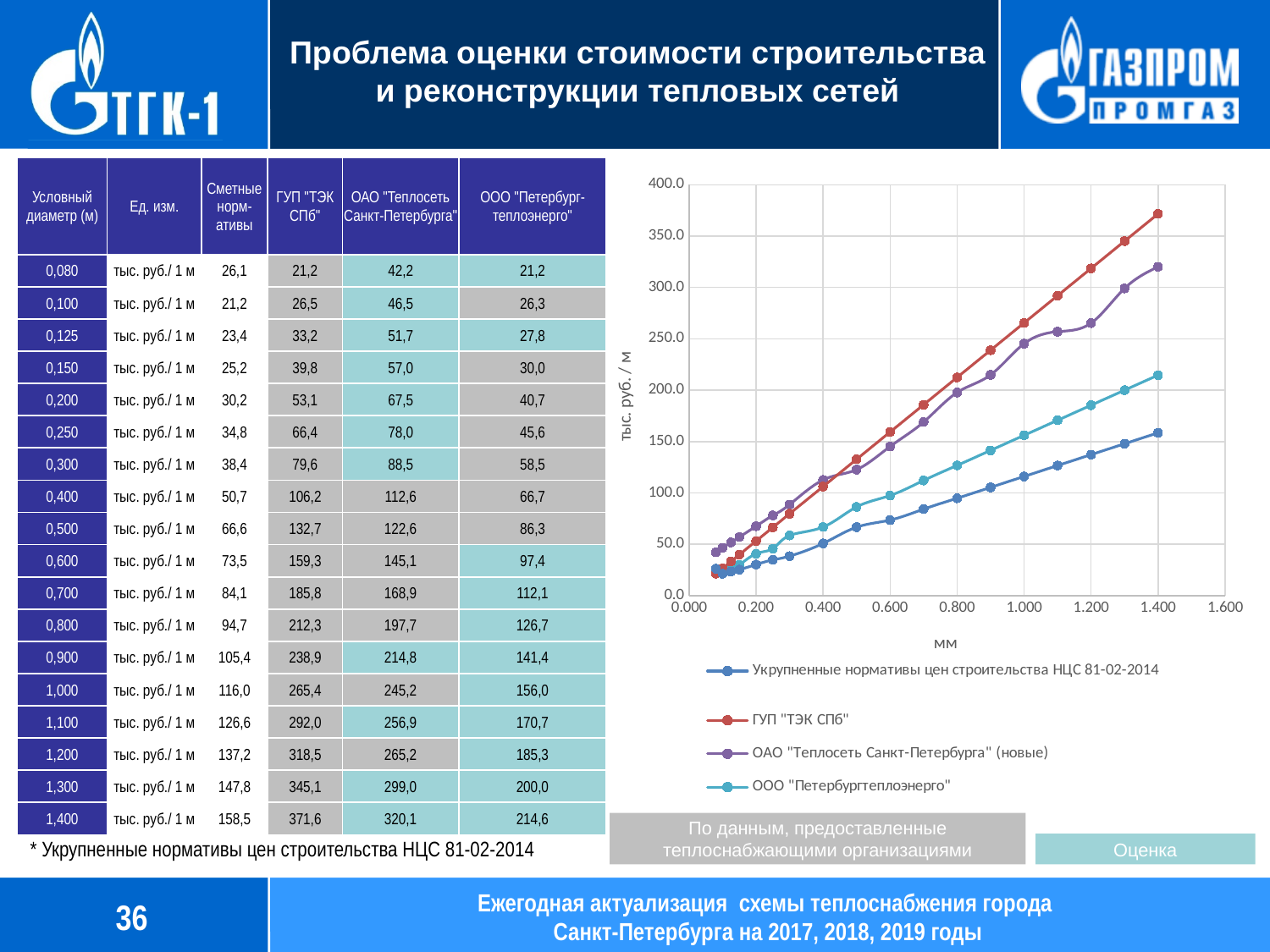
Is the value for ГУП "ТЭК СПб" at 1.400 greater or less than 350? greater Is the value for ООО "Петербургтеплоэнерго" at 1.400 greater or less than 200? greater According to the table on the slide, what is the value for ГУП "ТЭК СПб" at diameter 1,400? 371,6 At 1.000 on the x axis, which is larger: ГУП "ТЭК СПб" or ООО "Петербургтеплоэнерго"? ГУП "ТЭК СПб" What kind of chart is shown on the right of the slide? line chart Which series has the lowest value at 1.400 on the x axis? Укрупненные нормативы цен строительства НЦС 81-02-2014 How many data points does each series in the chart have? 18 How many series does the chart legend list? 4 What is the label of the chart's vertical axis? тыс. руб. / м Is the value for Укрупненные нормативы цен строительства НЦС 81-02-2014 at 1.400 greater or less than 200? less Do the values of the series rise or fall as the diameter increases along the x axis? rise Which series has the highest value at 1.400 on the x axis? ГУП "ТЭК СПб"